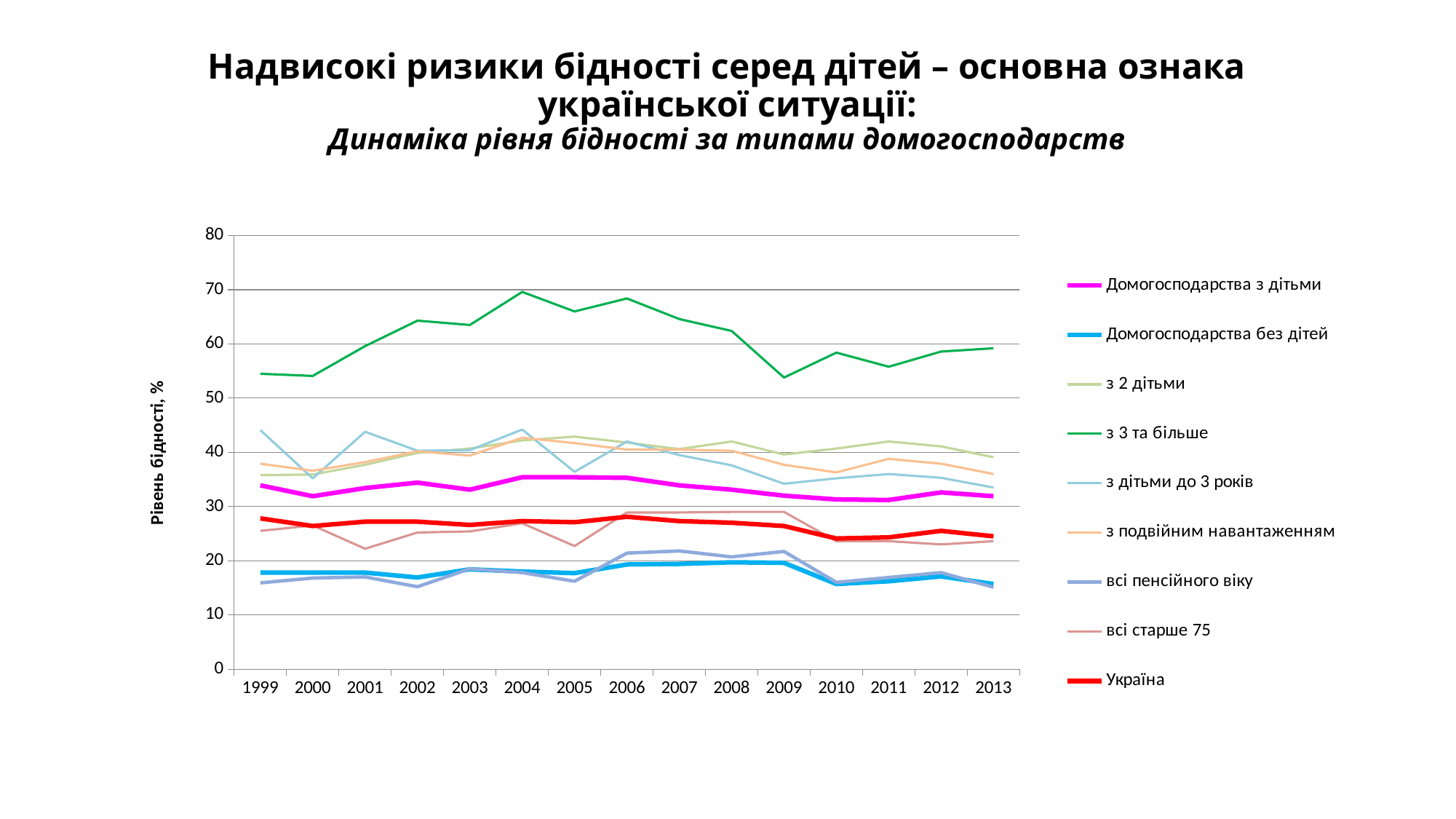
Is the value for "Україна" in 1999 greater or less than 30? less Is the value for "з 3 та більше" in 2004 greater or less than 60? greater Does the "з 3 та більше" line rise or fall from 2004 to 2009? fall What kind of chart is shown on the slide? line chart In 2004, which is larger: "з 3 та більше" or "з 2 дітьми"? з 3 та більше Is the value for "Домогосподарства без дітей" in 2010 greater or less than 20? less Which series has the highest values throughout the chart? з 3 та більше How many years are shown along the x axis? 15 What is the label of the vertical axis? Рівень бідності, % In 2013, which is larger: "Домогосподарства з дітьми" or "Домогосподарства без дітей"? Домогосподарства з дітьми How many series does the legend list? 9